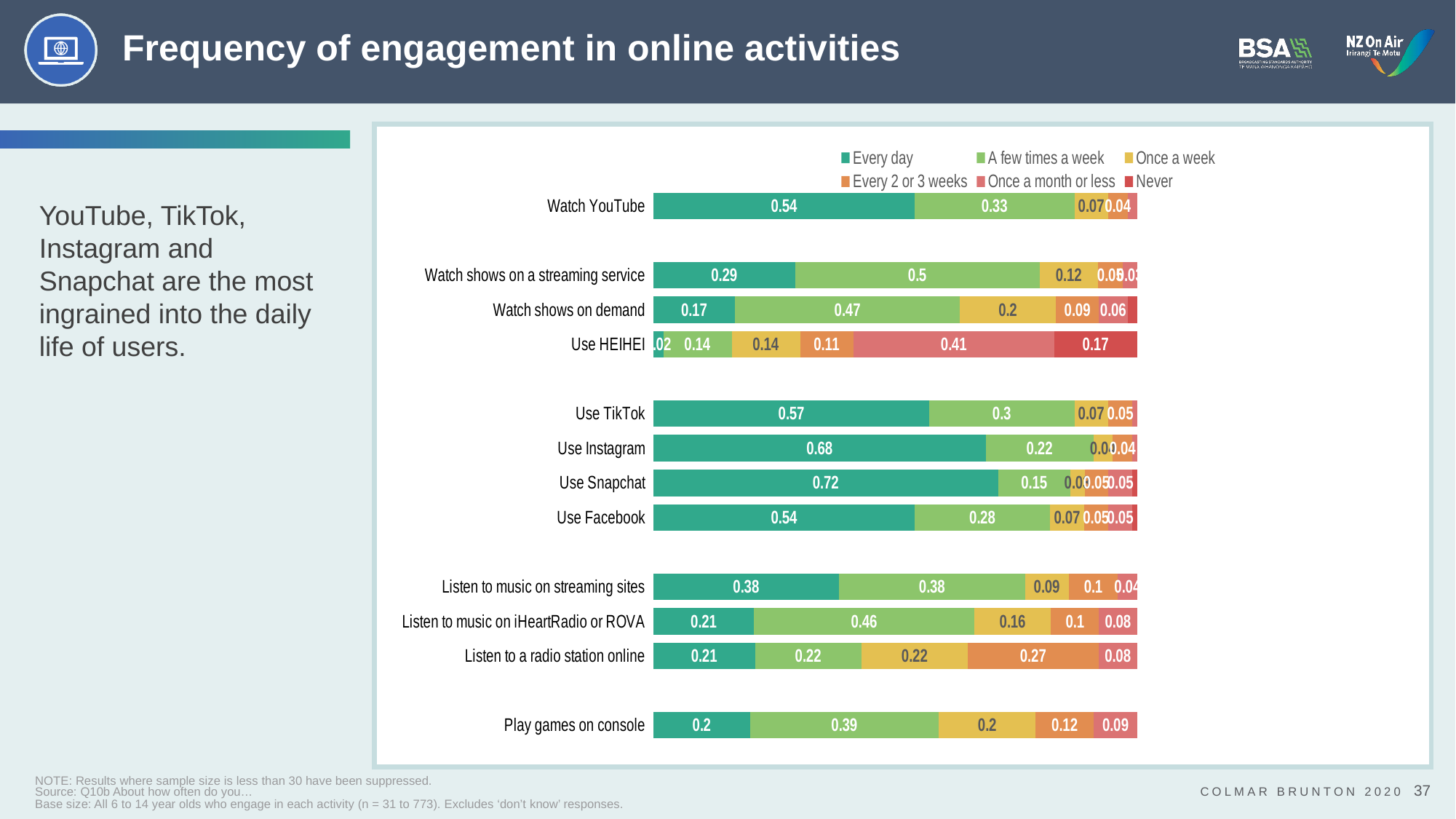
Which activity has the lowest 'Every day' value? Use HEIHEI What is the 'Every 2 or 3 weeks' value for Listen to a radio station online? 0.27 How many activities (categories) are plotted in the chart? 12 What is the 'Never' value for Use HEIHEI? 0.17 What is the 'A few times a week' value for Watch shows on a streaming service? 0.5 Which has the larger 'Every day' value: Watch shows on a streaming service or Watch shows on demand? Watch shows on a streaming service Which legend entry is shown in dark red? Never Which activity has the highest 'Every day' value? Use Snapchat How many series does the legend list? 6 What is the difference between the 'Every day' values for Use Snapchat and Use Instagram? 0.04 What is the 'Every day' value for Use Snapchat? 0.72 What kind of chart is shown on the slide? Stacked bar chart